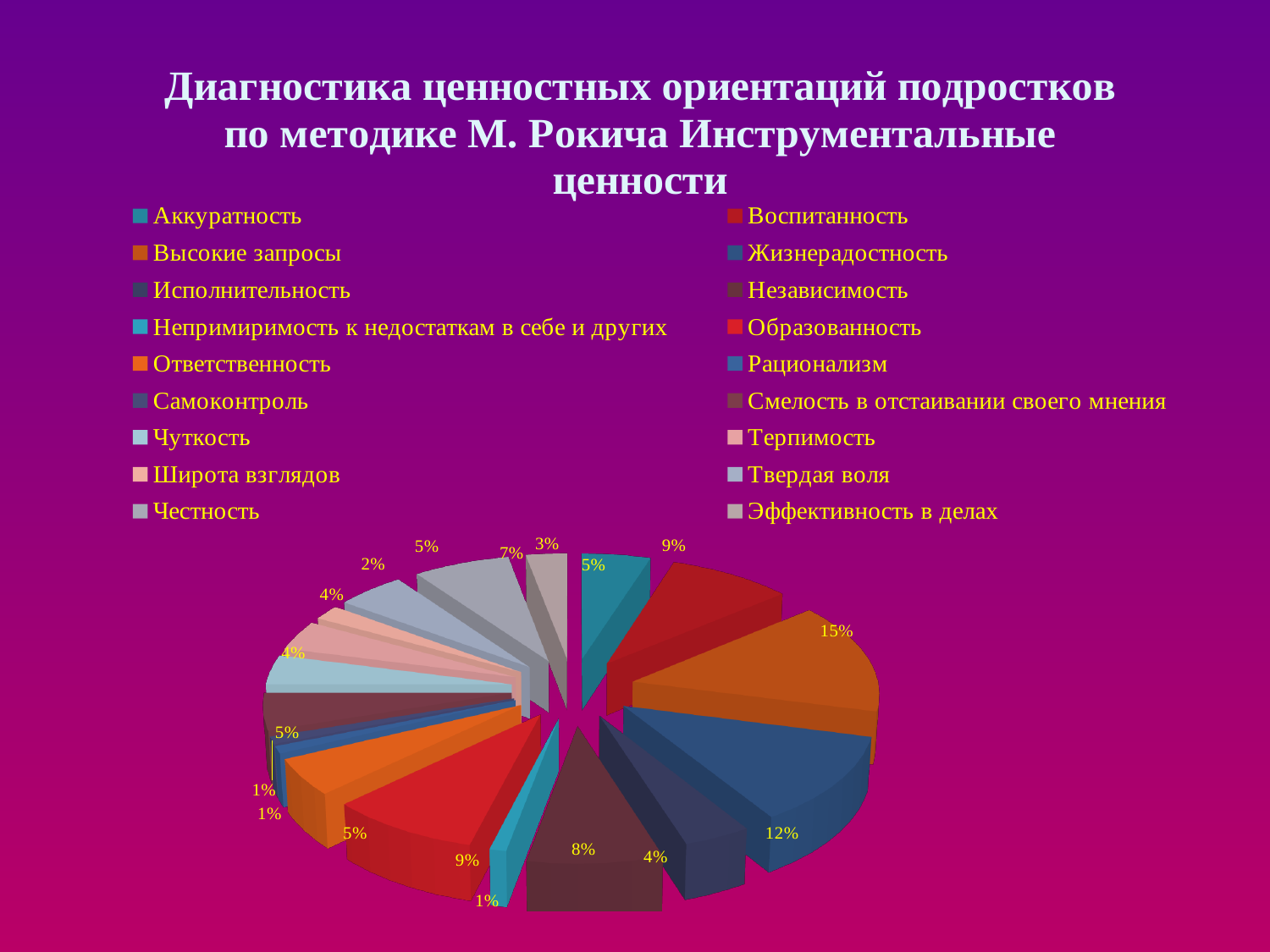
Which is larger: the slice for Высокие запросы or the slice for Жизнерадостность? Высокие запросы What share of the pie does the orange slice labelled Высокие запросы have? 15% What is the difference between the largest slice (15%) and the second largest slice (12%)? 3% What is the largest percentage shown on the pie chart? 15% What share of the pie does the teal slice labelled Аккуратность have? 5% What share of the pie does the blue slice labelled Жизнерадостность have? 12% What is the title of the slide containing the pie chart? Диагностика ценностных ориентаций подростков по методике М. Рокича Инструментальные ценности What is the smallest percentage shown on the pie chart? 1% How many categories does the legend of the pie chart list? 18 What kind of chart is shown on the slide? pie chart How many slices of the pie chart are labelled 1%? 3